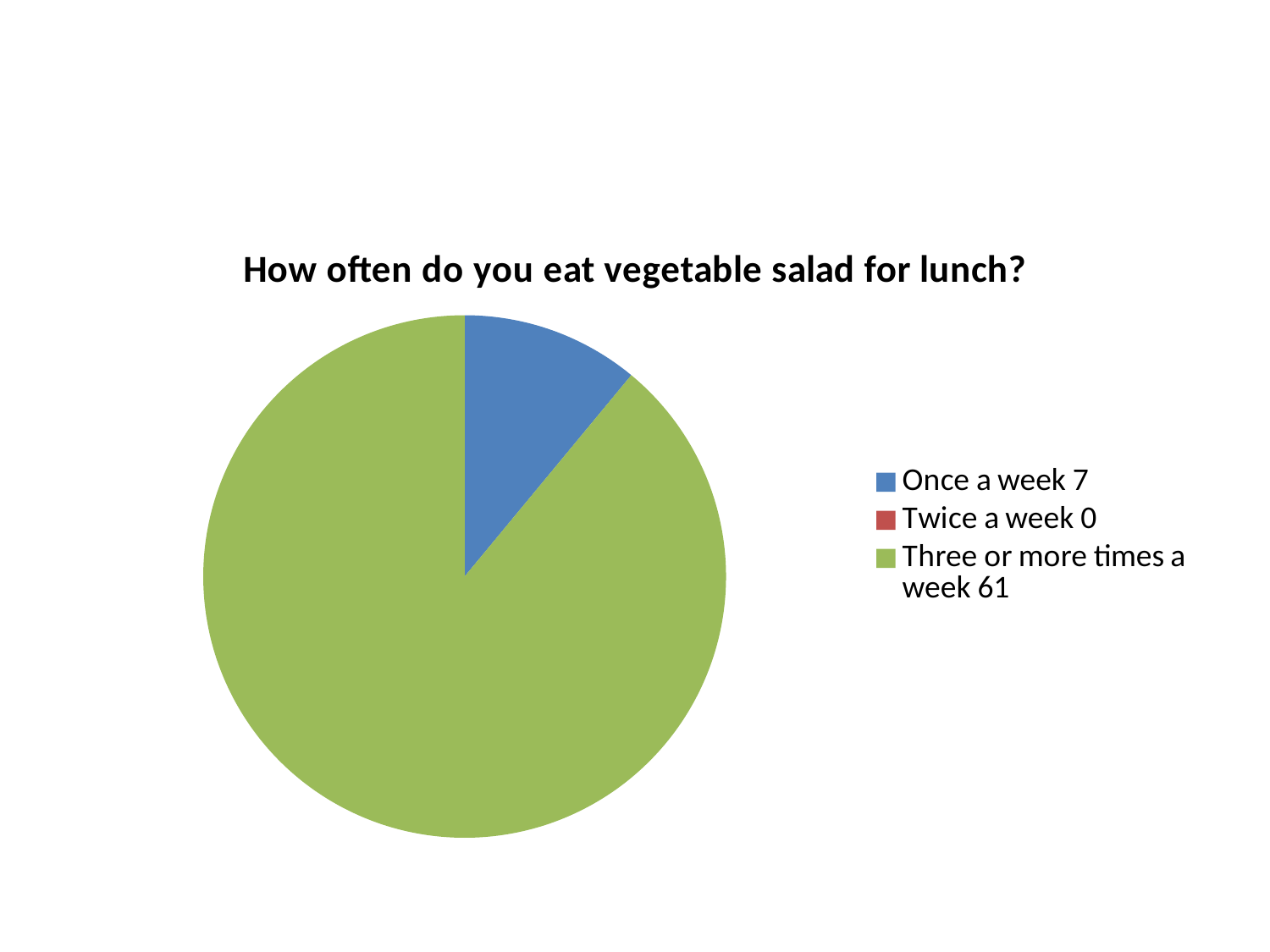
What is the title of the chart? How often do you eat vegetable salad for lunch? Which is larger, the value for "Once a week" or the value for "Three or more times a week"? Three or more times a week What colour is the slice for "Once a week"? Blue What is the total of all the values shown in the legend? 68 What is the value for "Once a week"? 7 What is the value for "Three or more times a week"? 61 How many categories does the legend list? 3 Which category has the highest value? Three or more times a week What is the value for "Twice a week"? 0 Which category has the lowest value? Twice a week What is the difference between the values for "Three or more times a week" and "Once a week"? 54 What kind of chart is shown on the slide? Pie chart